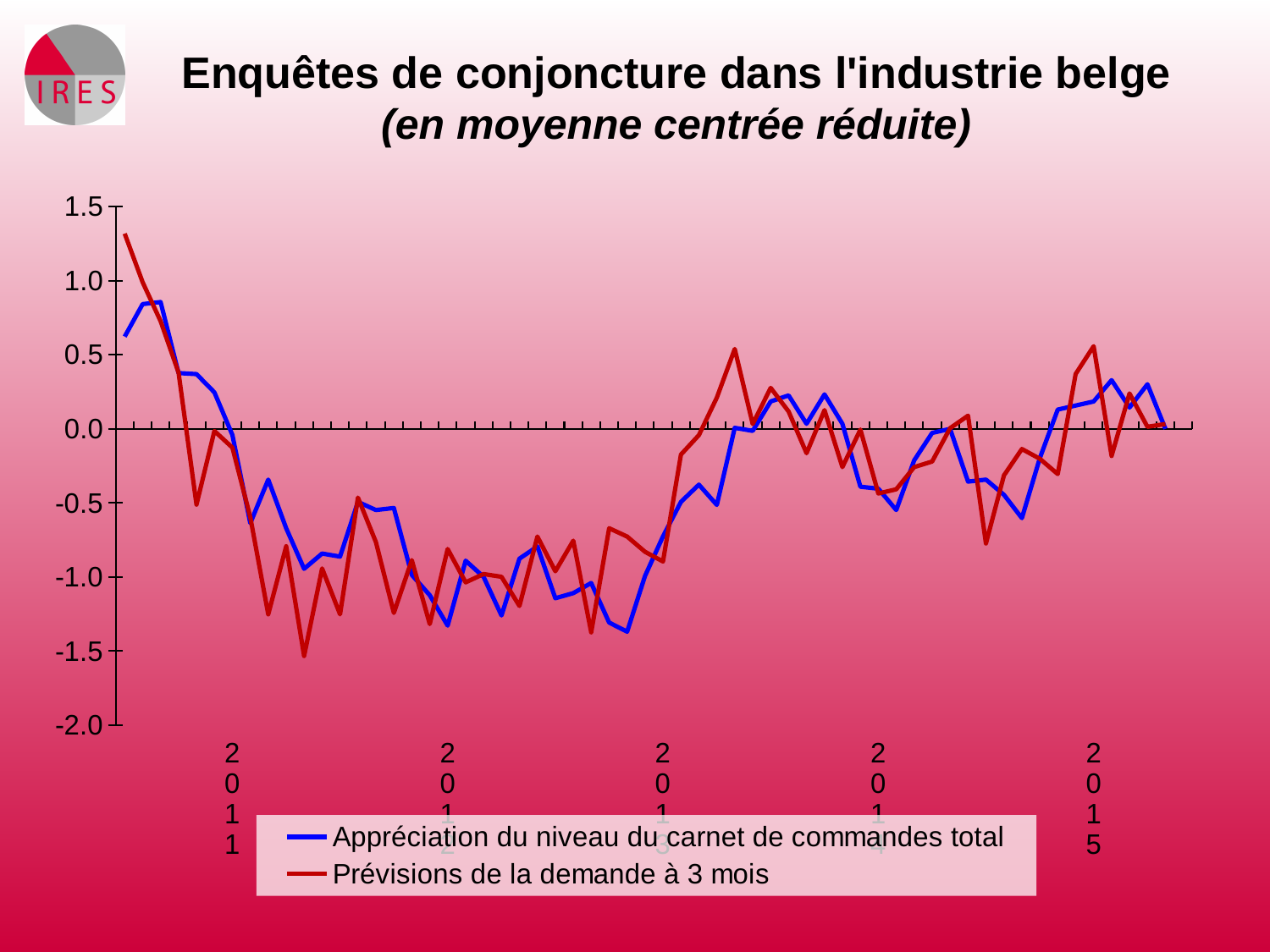
Is the lowest value of the 'Appréciation du niveau du carnet de commandes total' series greater or less than -1.0? less What is the title of the chart? Enquêtes de conjoncture dans l'industrie belge (en moyenne centrée réduite) Which series is drawn in red? Prévisions de la demande à 3 mois Is the first value of the 'Appréciation du niveau du carnet de commandes total' series greater or less than 0.5? greater What is the highest value shown on the vertical axis? 1.5 How many year labels are shown on the horizontal axis? 5 How many series does the legend list? 2 What kind of chart is shown on the slide? line chart Do the values of the 'Appréciation du niveau du carnet de commandes total' series rise or fall between the start of the chart and 2012? fall Is the lowest value of the 'Prévisions de la demande à 3 mois' series greater or less than -1.0? less